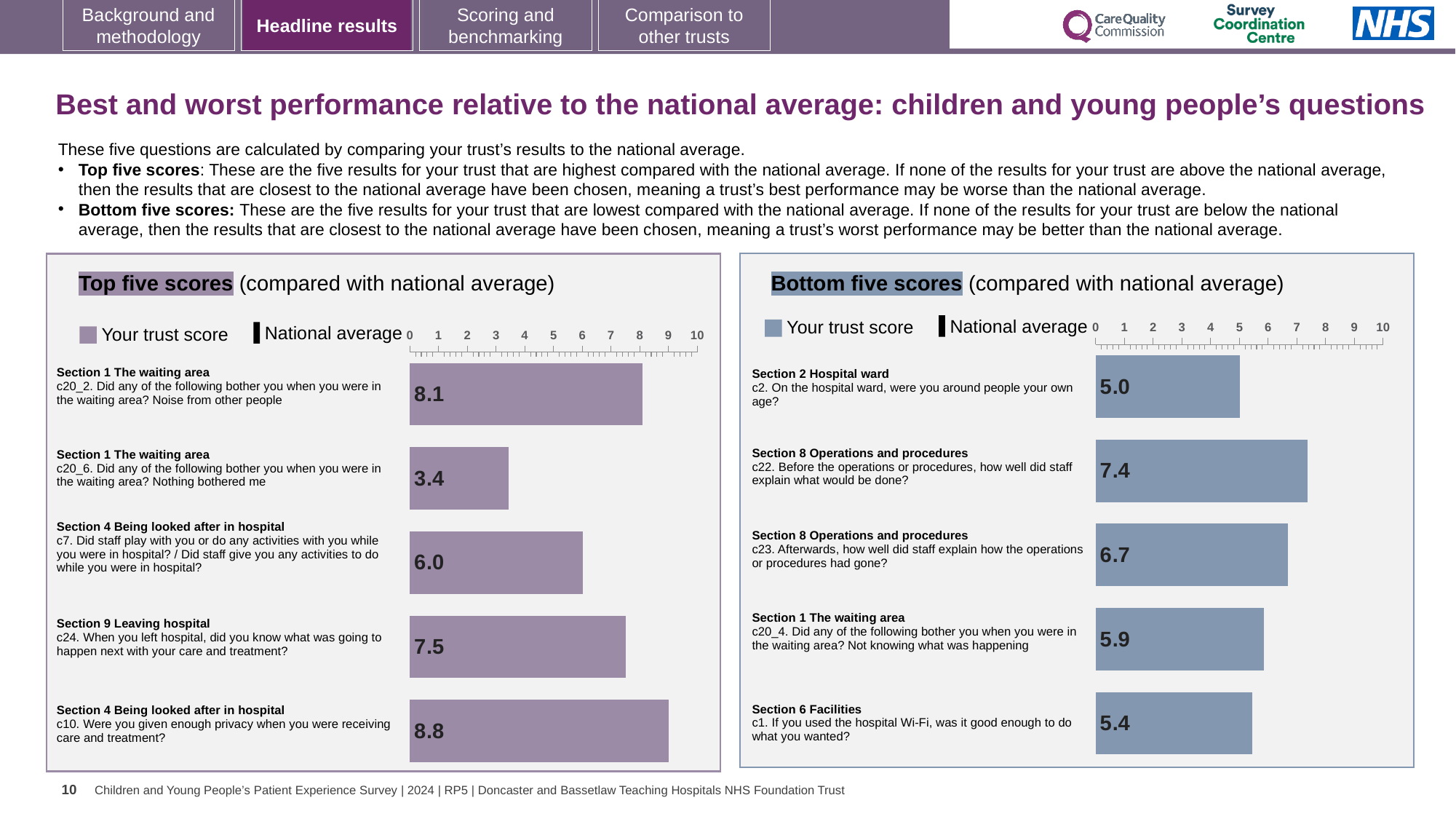
In the Bottom five scores chart, what is the trust score for c23 (how well staff explained how the operations or procedures had gone)? 6.7 How many questions are shown in the Bottom five scores chart? 5 In the Bottom five scores chart, which has the larger trust score: c20_4 or c1? c20_4 In the Top five scores chart, what is the trust score for c20_2 (noise from other people in the waiting area)? 8.1 In the Bottom five scores chart, what is the trust score for c2 (on the hospital ward, were you around people your own age)? 5.0 In the Top five scores chart, what is the trust score for c10 (enough privacy when receiving care and treatment)? 8.8 What type of chart is the Top five scores chart? Bar chart In the Bottom five scores chart, which question has the lowest trust score? c2. On the hospital ward, were you around people your own age? In the Top five scores chart, which question has the lowest trust score? c20_6. Did any of the following bother you when you were in the waiting area? Nothing bothered me In the Bottom five scores chart, which question has the highest trust score? c22. Before the operations or procedures, how well did staff explain what would be done? In the Top five scores chart, which question has the highest trust score? c10. Were you given enough privacy when you were receiving care and treatment? In the Top five scores chart, what is the difference between the trust scores for c10 and c20_6? 5.4